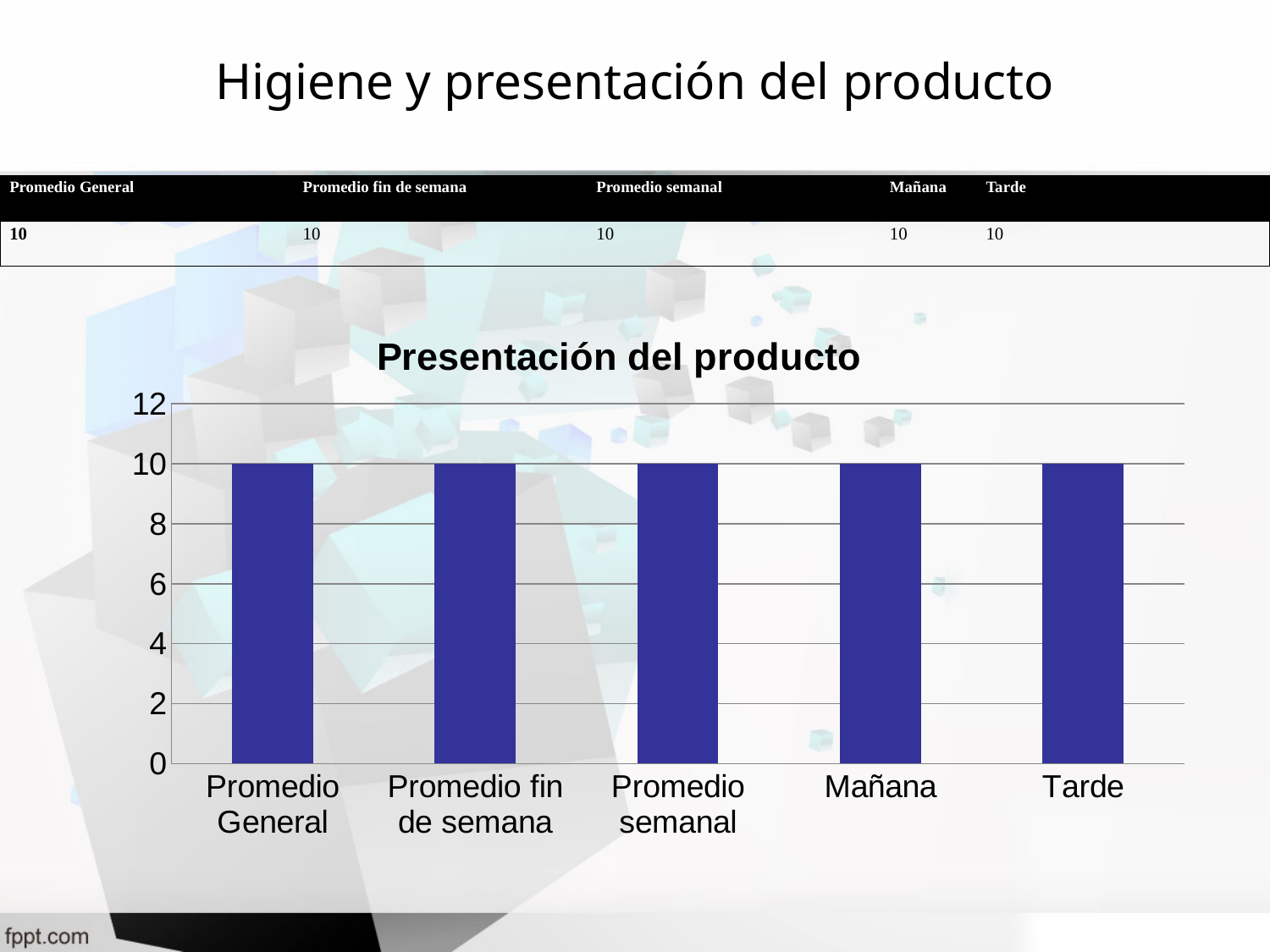
Is the value for Tarde greater or less than 12? less How many categories are plotted in the chart? 5 What is the value for Promedio semanal? 10 What is the value for Tarde? 10 What is the value for Promedio General? 10 What is the title of the chart? Presentación del producto What is the difference between the values for Mañana and Tarde? 0 What is the value for Promedio fin de semana? 10 Is the value for Promedio semanal greater or less than 8? greater Do the values rise, fall, or stay the same across the categories from left to right? stay the same What is the value for Mañana? 10 What type of chart is shown on the slide? bar chart